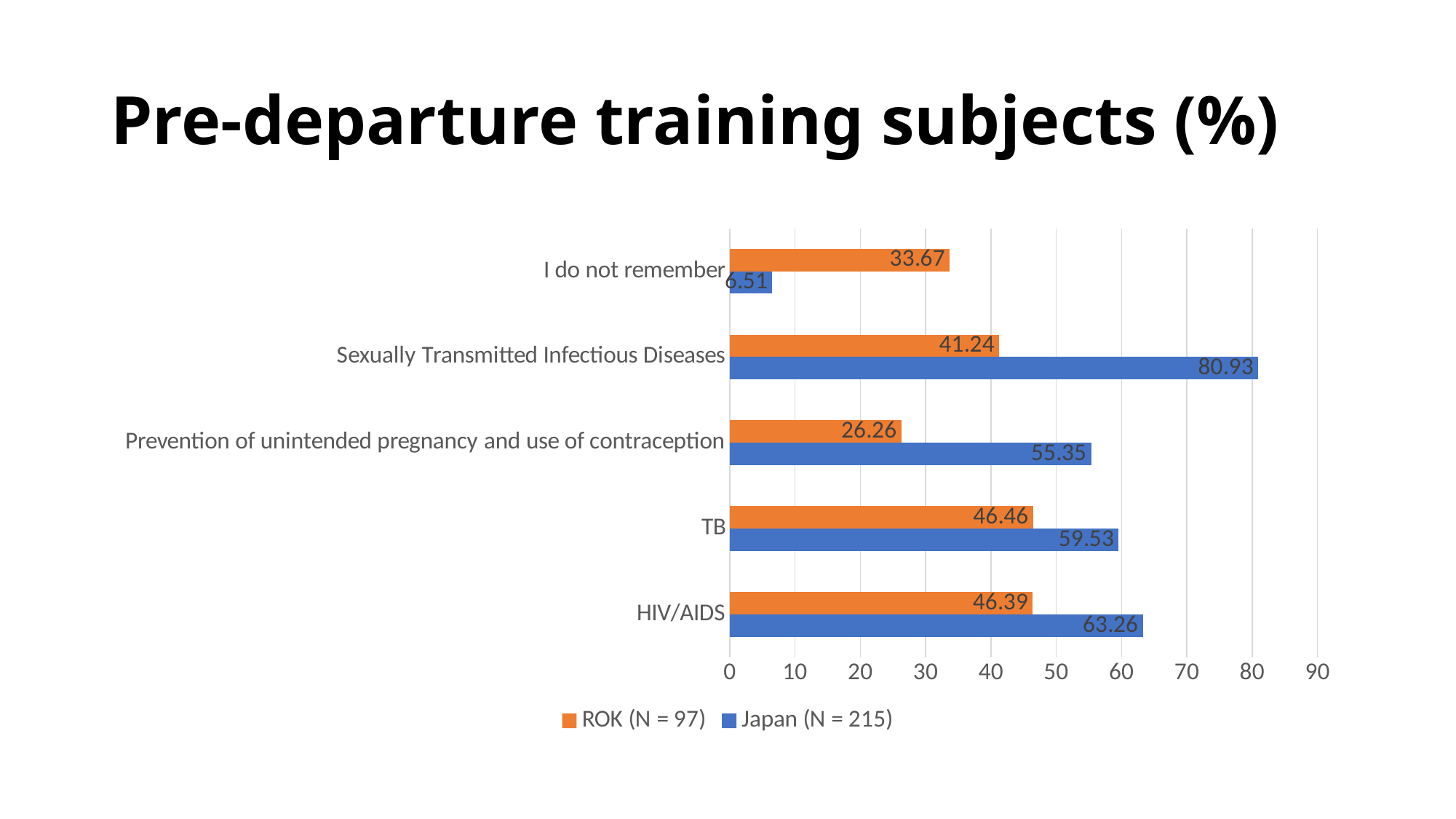
Which category has the lowest value for Japan (N = 215)? I do not remember What is the difference between the Japan (N = 215) and ROK (N = 97) values for Sexually Transmitted Infectious Diseases? 39.69 What is the value for ROK (N = 97) for TB? 46.46 What is the value for ROK (N = 97) for Prevention of unintended pregnancy and use of contraception? 26.26 Which category has the lowest value for ROK (N = 97)? Prevention of unintended pregnancy and use of contraception What kind of chart is shown on the slide? Bar chart Which category has the highest value for Japan (N = 215)? Sexually Transmitted Infectious Diseases What is the value for Japan (N = 215) for I do not remember? 6.51 For I do not remember, which series has the larger value, ROK (N = 97) or Japan (N = 215)? ROK (N = 97) How many series does the legend list? 2 How many categories are shown on the chart? 5 What is the value for Japan (N = 215) for Sexually Transmitted Infectious Diseases? 80.93